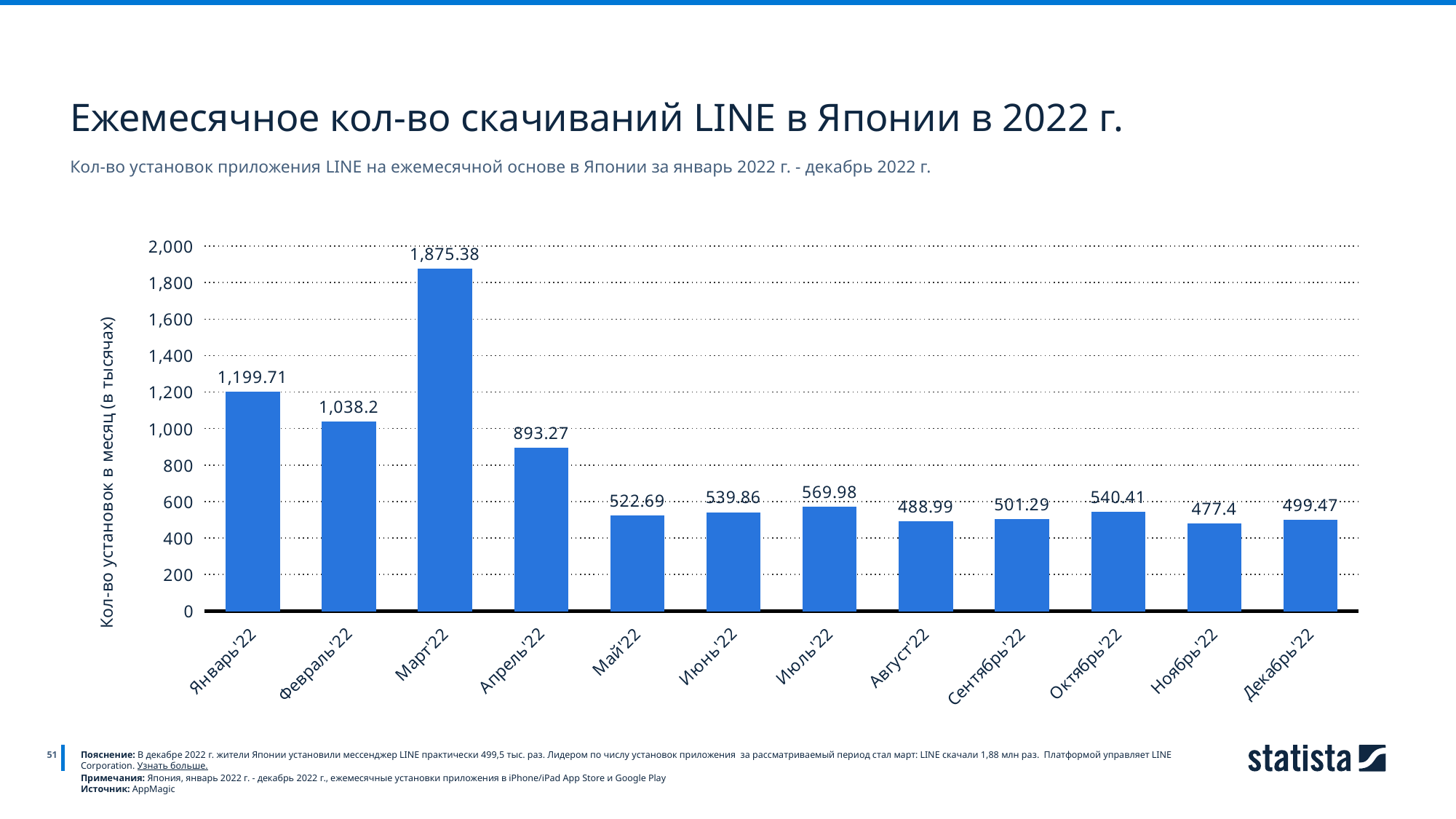
What is the value for Январь'22? 1,199.71 Which is larger, the value for Февраль'22 or Апрель'22? Февраль'22 Do the values rise or fall from Март'22 to Май'22? fall Which month has the lowest number of installs? Ноябрь'22 Which month has the highest number of installs? Март'22 What is the difference between the values for Март'22 and Январь'22? 675.67 What is the label of the vertical axis? Кол-во установок в месяц (в тысячах) What type of chart is shown on the slide? Bar chart What is the value for Март'22? 1,875.38 Is the value for Апрель'22 greater or less than 1,000? less How many months (categories) are plotted on the chart? 12 What is the value for Декабрь'22? 499.47